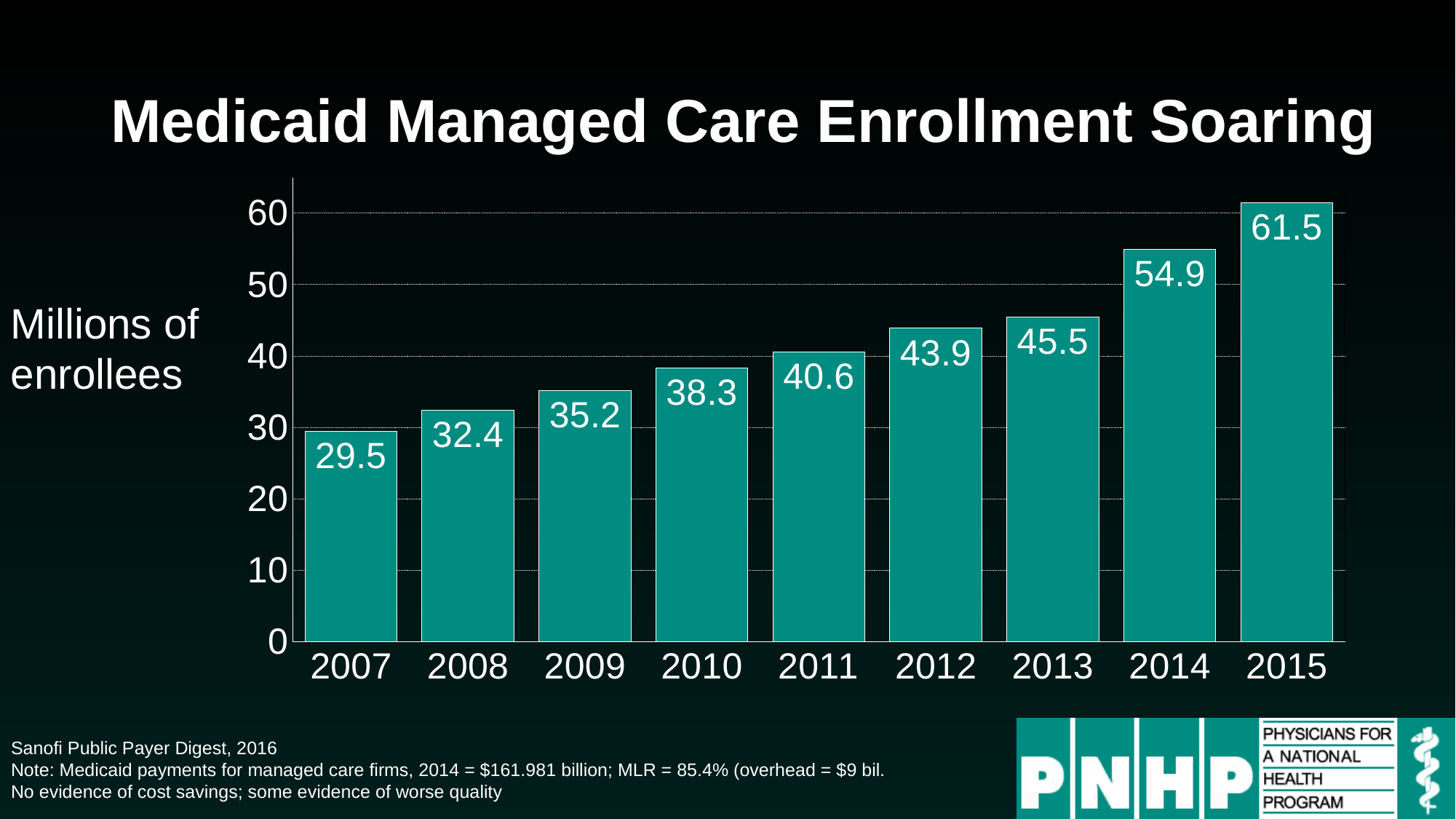
Which year has the lowest value? 2007 What is the value for 2012? 43.9 What is the value for 2007? 29.5 Which is larger, the value for 2009 or the value for 2013? 2013 Is the value for 2010 greater or less than 40? less What is the difference between the values for 2015 and 2014? 6.6 What is the value for 2015? 61.5 What is the difference between the values for 2011 and 2007? 11.1 What kind of chart is shown on the slide? bar chart Do the values rise or fall from 2007 to 2015? rise How many years are shown on the x axis? 9 Which year has the highest value? 2015